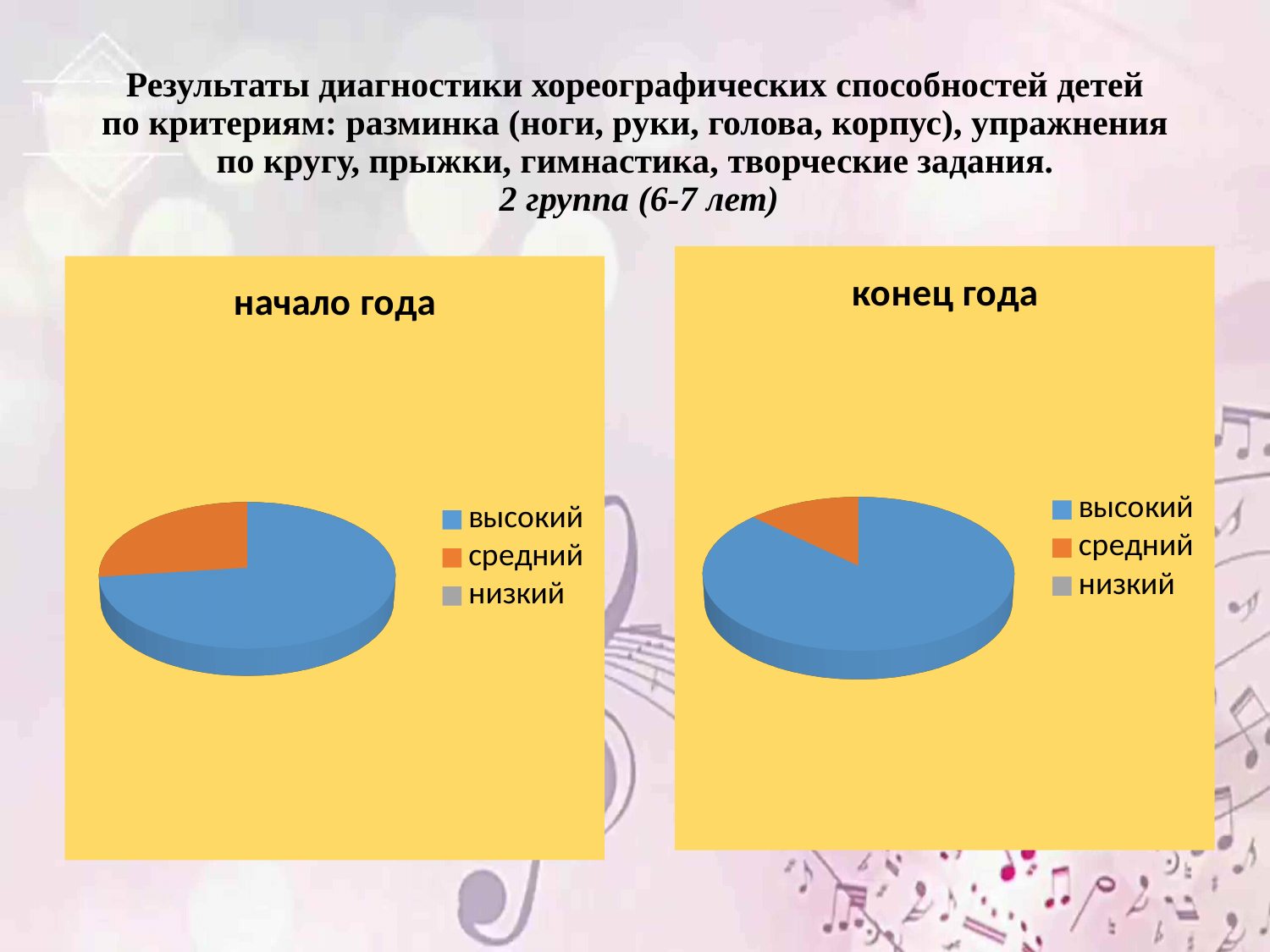
In the chart titled "начало года", how many entries does the legend list? 3 In the chart titled "конец года", which slice is larger: высокий or средний? высокий In the chart titled "конец года", what colour represents the category средний? orange Which of the two pie charts has the larger средний slice, "начало года" or "конец года"? начало года What is the title of the pie chart on the left side of the slide? начало года What kind of chart is the chart titled "конец года"? pie chart In the chart titled "конец года", how many entries does the legend list? 3 What kind of chart is the chart titled "начало года"? pie chart In the chart titled "начало года", which category has the largest slice? высокий In the chart titled "конец года", which category has the largest slice? высокий In the chart titled "начало года", which slice is larger: высокий or средний? высокий